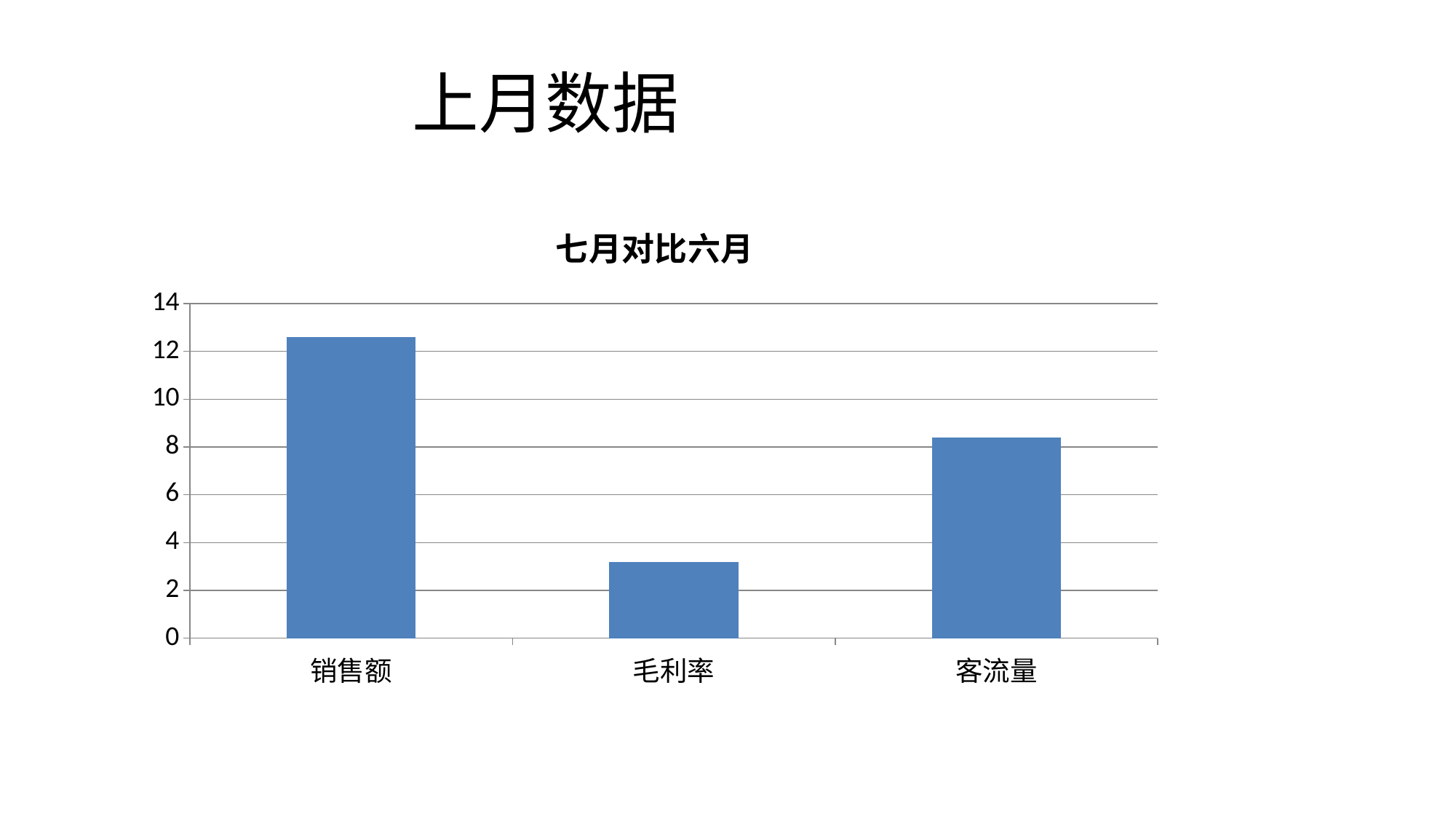
Which is larger, the value for 销售额 or the value for 客流量? 销售额 What is the maximum value shown on the vertical axis? 14 How many categories are plotted on the x axis? 3 Is the value for 客流量 greater or less than 8? greater What kind of chart is shown on the slide? bar chart Is the value for 销售额 greater or less than 14? less Which category has the lowest value? 毛利率 Which category has the highest value? 销售额 What is the title of the chart? 七月对比六月 Is the value for 毛利率 greater or less than 4? less Which is larger, the value for 客流量 or the value for 毛利率? 客流量